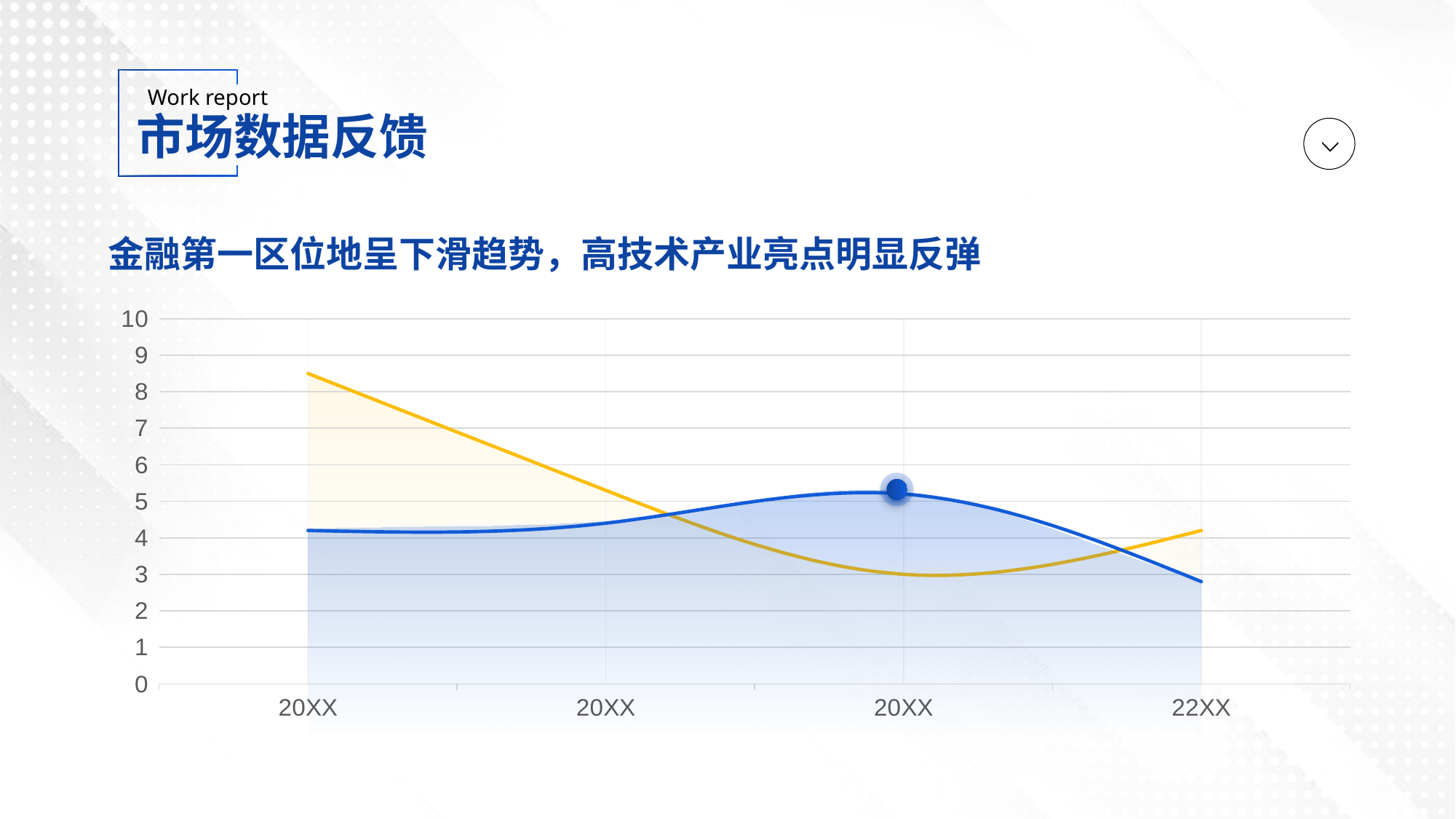
Is the value of the blue line at 22XX greater or less than 4? less How many points are labelled along the x axis of the chart? 4 Is the value of the yellow line at the first x-axis point greater or less than 8? greater What kind of chart is shown on the slide? line chart Is the value of the yellow line at the third x-axis point greater or less than 4? less What is the title of the slide containing the chart? 市场数据反馈 At which x-axis point does the blue line reach its highest value? the third point (20XX) How many lines are plotted on the chart? 2 At the third x-axis point, which line has the higher value, the yellow line or the blue line? the blue line Does the yellow line rise or fall from the first x-axis point to the third x-axis point? fall At the first x-axis point, which line has the higher value, the yellow line or the blue line? the yellow line